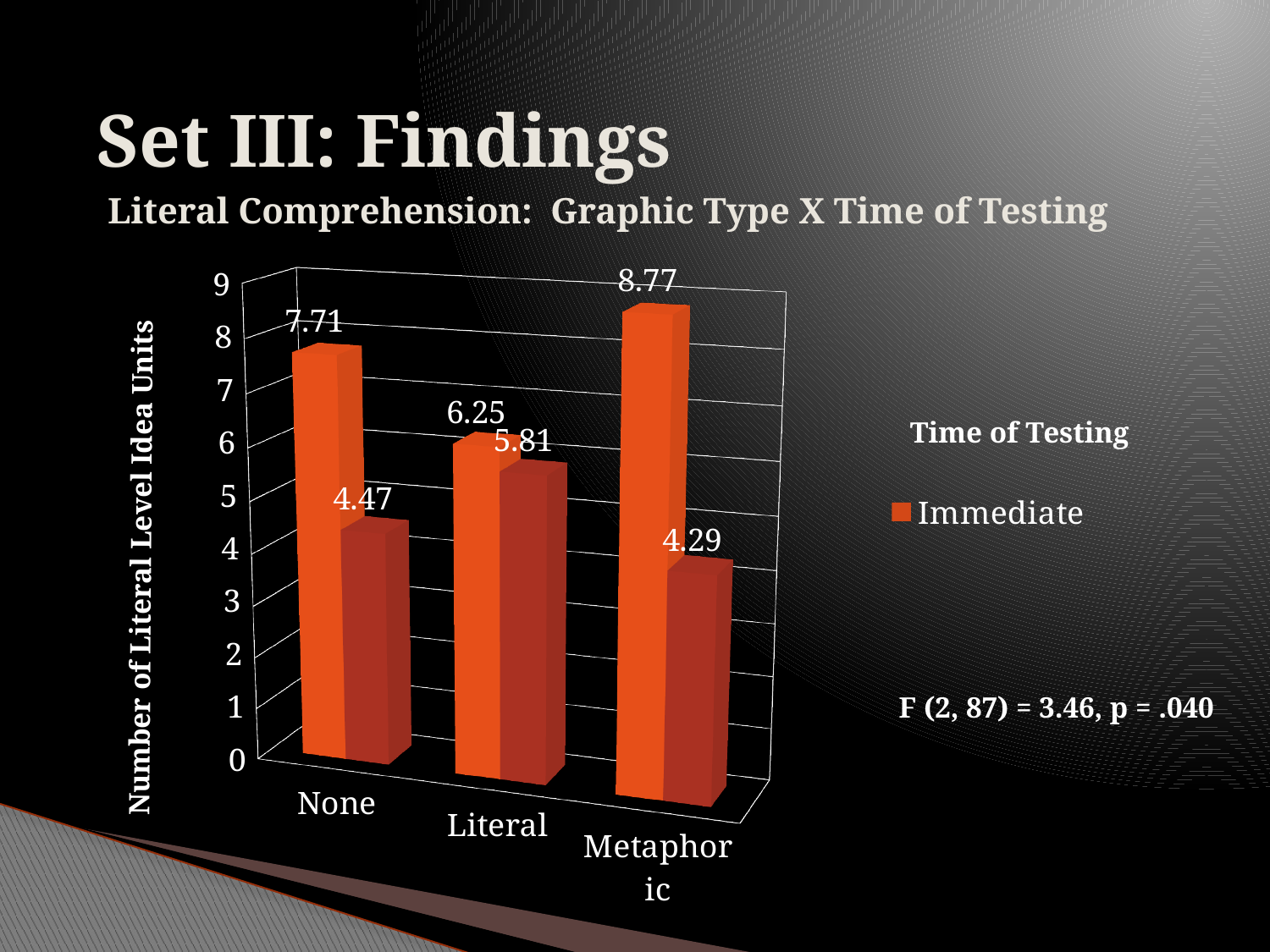
What is the Immediate value for the Literal graphic type? 6.25 What kind of chart is shown on the slide? bar chart What is the Immediate value for the Metaphoric graphic type? 8.77 What is the Immediate value for the None graphic type? 7.71 Which graphic type has the lowest Immediate value? Literal What is the difference between the Immediate values for Metaphoric and None? 1.06 How many graphic type categories are shown on the x axis? 3 Is the Immediate value for Metaphoric greater or less than 8? greater What is the difference between the Immediate values for None and Literal? 1.46 Which graphic type has the highest Immediate value? Metaphoric What is the title of the vertical axis? Number of Literal Level Idea Units Which has a larger Immediate value, None or Literal? None